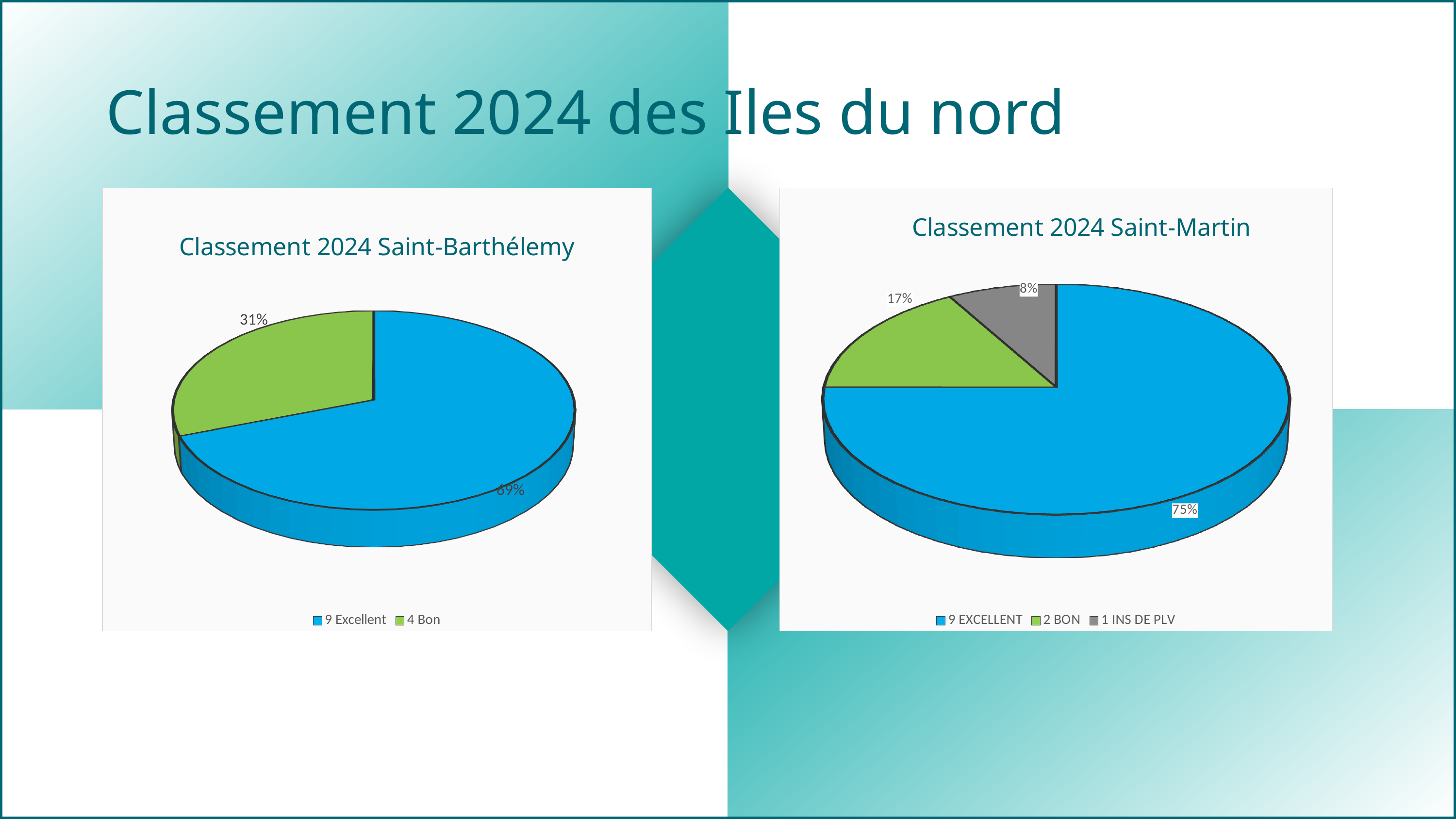
In the 'Classement 2024 Saint-Barthélemy' chart, what is the difference in percentage points between the '9 Excellent' and '4 Bon' slices? 38 In the 'Classement 2024 Saint-Martin' chart, what colour is the '1 INS DE PLV' slice? Grey In the 'Classement 2024 Saint-Martin' chart, what share of the pie is labelled '2 BON'? 17% In the 'Classement 2024 Saint-Martin' chart, what share of the pie is labelled '9 EXCELLENT'? 75% In the 'Classement 2024 Saint-Martin' chart, which category has the smallest slice? 1 INS DE PLV In the 'Classement 2024 Saint-Martin' chart, what share of the pie is labelled '1 INS DE PLV'? 8% How many slices does the 'Classement 2024 Saint-Martin' chart have? 3 In the 'Classement 2024 Saint-Barthélemy' chart, which category has the largest slice? 9 Excellent What kind of chart is the 'Classement 2024 Saint-Barthélemy' chart? Pie chart In the 'Classement 2024 Saint-Martin' chart, what is the difference in percentage points between the '9 EXCELLENT' and '2 BON' slices? 58